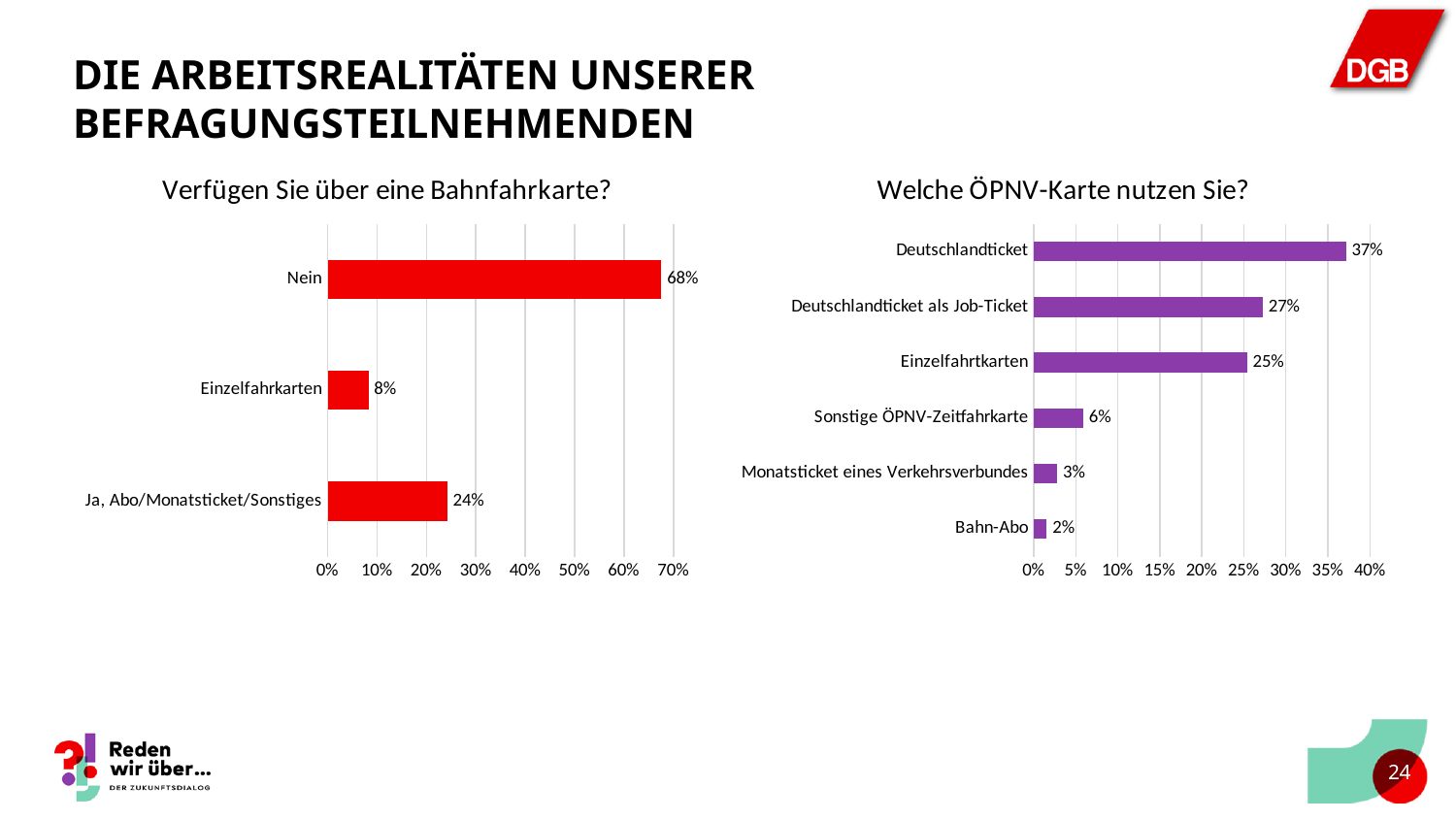
In the chart 'Welche ÖPNV-Karte nutzen Sie?', what is the difference between Deutschlandticket and Einzelfahrtkarten? 12 percentage points What type of chart is 'Welche ÖPNV-Karte nutzen Sie?'? Bar chart In the chart 'Welche ÖPNV-Karte nutzen Sie?', which category has the highest value? Deutschlandticket In the chart 'Welche ÖPNV-Karte nutzen Sie?', how many categories are shown? 6 In the chart 'Verfügen Sie über eine Bahnfahrkarte?', what is the value for Nein? 68% In the chart 'Welche ÖPNV-Karte nutzen Sie?', what is the value for Deutschlandticket als Job-Ticket? 27% In the chart 'Verfügen Sie über eine Bahnfahrkarte?', what is the difference between Nein and Ja, Abo/Monatsticket/Sonstiges? 44 percentage points In the chart 'Verfügen Sie über eine Bahnfahrkarte?', what is the value for Einzelfahrkarten? 8% In the chart 'Welche ÖPNV-Karte nutzen Sie?', which is larger: Einzelfahrtkarten or Sonstige ÖPNV-Zeitfahrkarte? Einzelfahrtkarten In the chart 'Verfügen Sie über eine Bahnfahrkarte?', how many categories are shown? 3 In the chart 'Verfügen Sie über eine Bahnfahrkarte?', which category has the lowest value? Einzelfahrkarten In the chart 'Welche ÖPNV-Karte nutzen Sie?', which category has the lowest value? Bahn-Abo